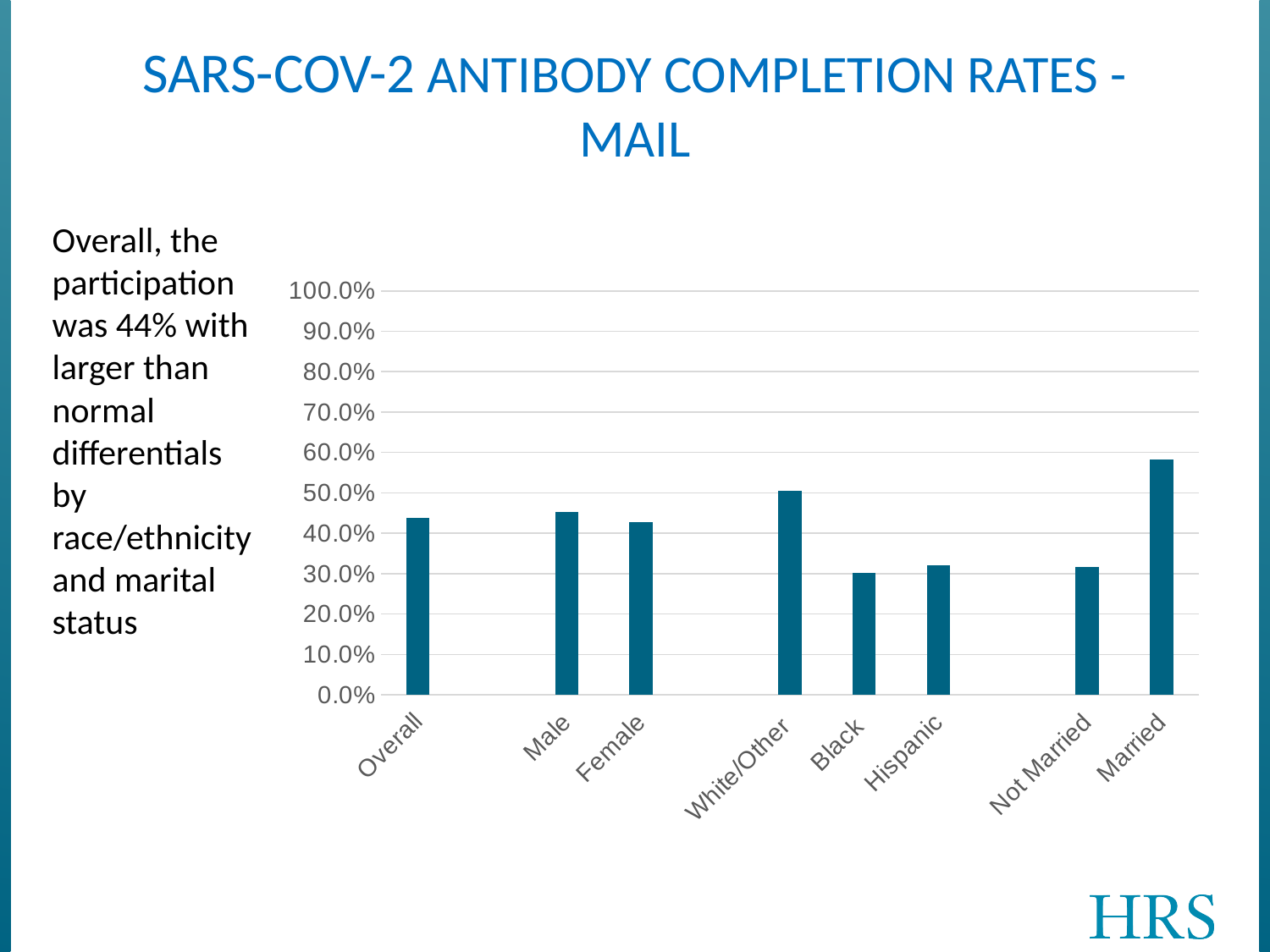
What kind of chart is shown on the slide? bar chart What is the highest value shown on the chart's vertical axis? 100.0% Is the value for Married greater or less than 50.0%? greater Is the value for White/Other greater or less than 40.0%? greater Is the value for Black greater or less than 40.0%? less How many categories (bars) are plotted in the chart? 8 What is the title of the slide containing the chart? SARS-COV-2 ANTIBODY COMPLETION RATES - MAIL Which category has the highest completion rate in the chart? Married Which is larger, the value for White/Other or the value for Black? White/Other Which is larger, the value for Married or the value for Not Married? Married